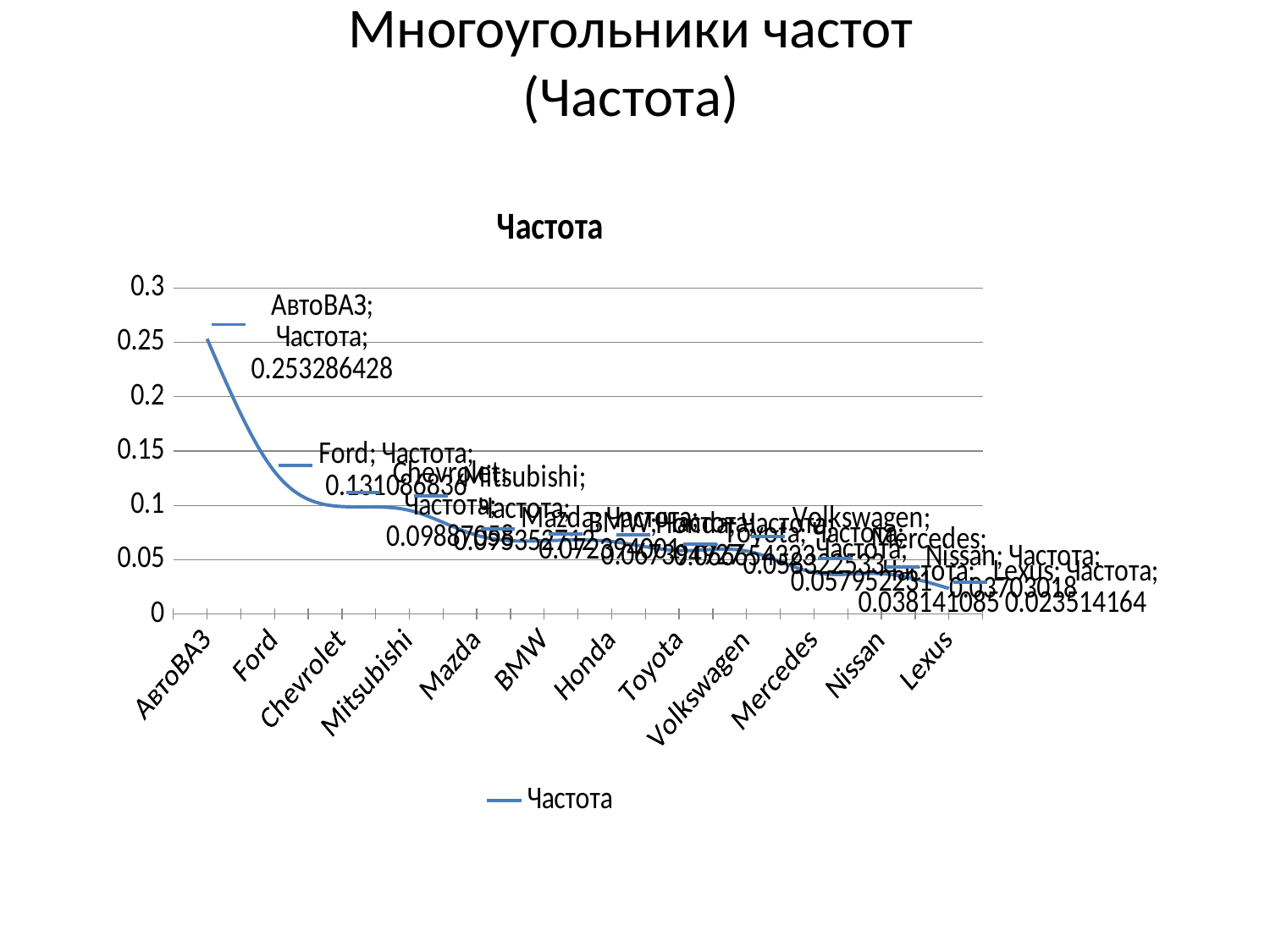
Is the value for Ford greater or less than 0.1? greater How many series does the legend list? 1 Is the value for Mercedes greater or less than 0.1? less What is the value for Nissan? 0.03703018 How many categories are plotted along the x axis? 12 Do the values rise or fall from left to right along the x axis? fall What is the value for АвтоВАЗ? 0.253286428 Which category has the highest value? АвтоВАЗ What is the value for Lexus? 0.023514164 Which category has the lowest value? Lexus Which is larger, the value for Ford or the value for Nissan? Ford What kind of chart is shown on the slide? line chart